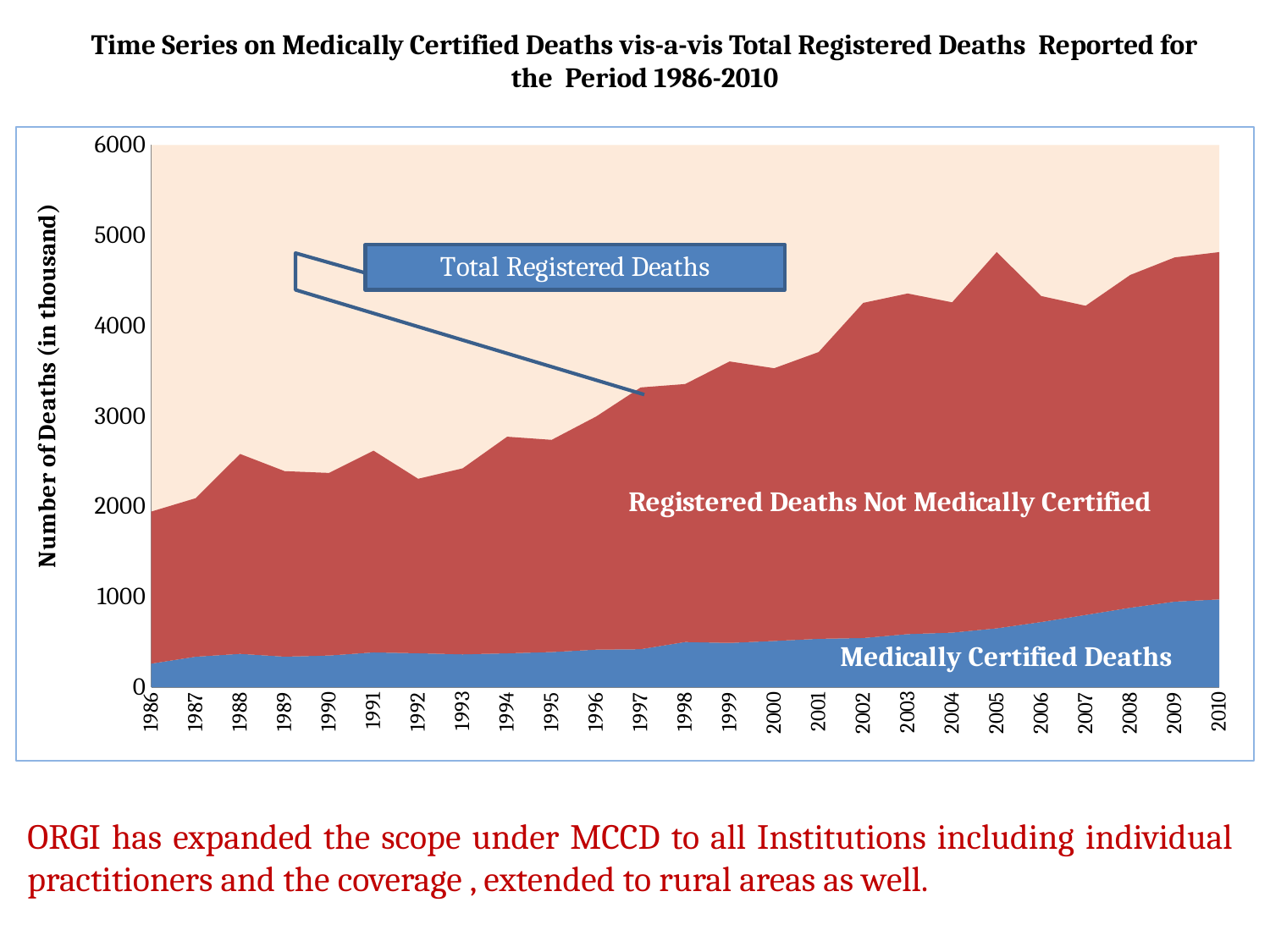
Is the total registered deaths value for 2002 greater or less than 4000? greater Which year has higher total registered deaths, 2005 or 2006? 2005 What is the label of the y axis of the chart? Number of Deaths (in thousand) Do Medically Certified Deaths generally rise or fall from 1986 to 2010? Rise Is the total registered deaths value for 1992 greater or less than 3000? less What kind of chart is shown on the slide? Stacked area chart How many series are stacked in the chart? 2 How many years are plotted along the x axis of the chart? 25 In which year are Medically Certified Deaths highest? 2010 In which year are total registered deaths lowest? 1986 Is the Medically Certified Deaths value for 1986 greater or less than 1000? less Which series is shown in blue at the bottom of the chart? Medically Certified Deaths